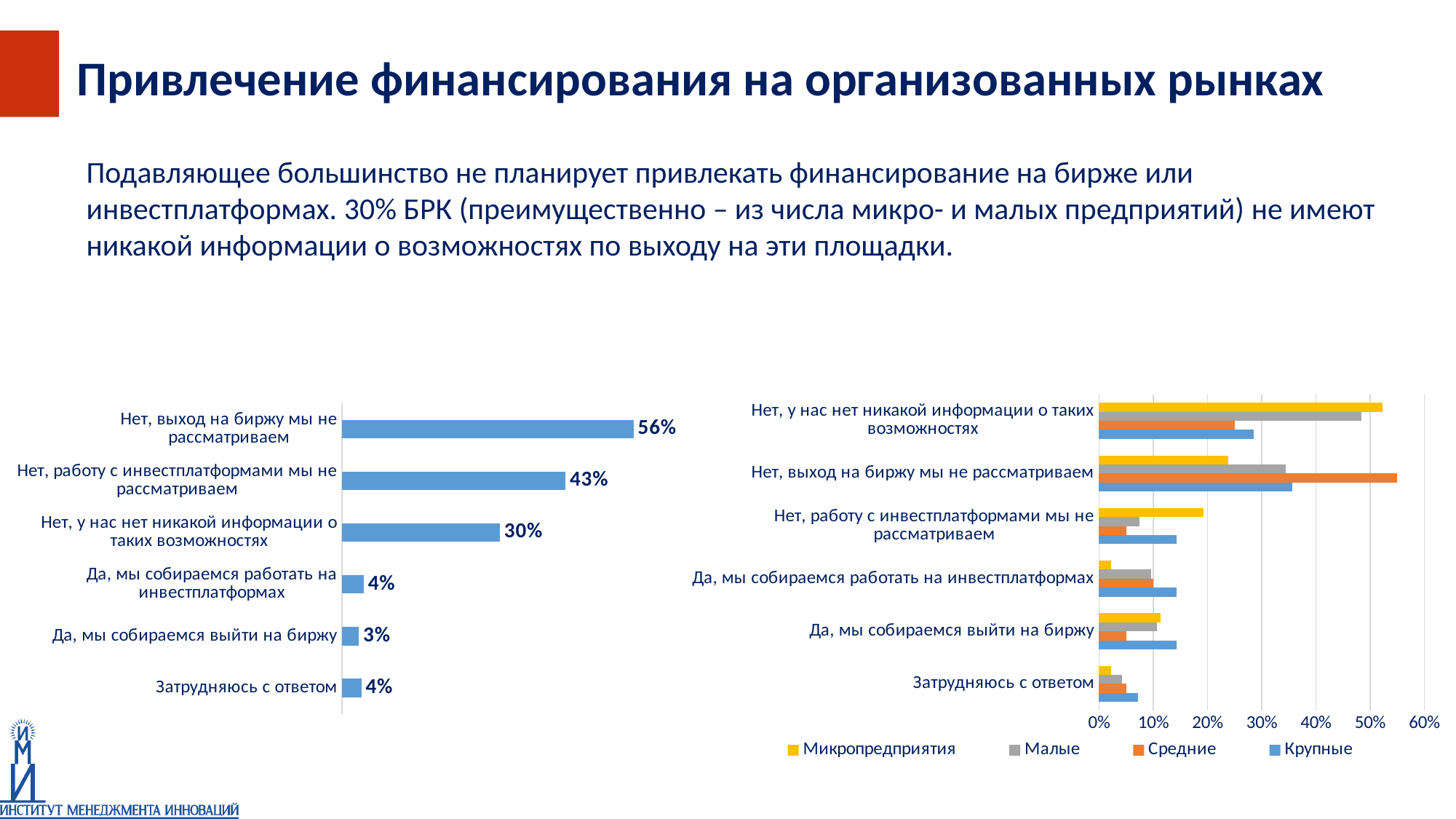
In the left chart, what is the value for "Нет, выход на биржу мы не рассматриваем"? 56% In the left chart, which category has the lowest value? Да, мы собираемся выйти на биржу In the right chart, how many series does the legend list? 4 In the left chart, what is the difference between "Нет, выход на биржу мы не рассматриваем" and "Нет, работу с инвестплатформами мы не рассматриваем"? 13% In the right chart, is the value of Средние for "Нет, выход на биржу мы не рассматриваем" greater or less than 50%? greater In the left chart, which category has the highest value? Нет, выход на биржу мы не рассматриваем In the left chart, how many categories are shown? 6 In the right chart, is the value of Малые for "Нет, выход на биржу мы не рассматриваем" greater or less than 30%? greater What kind of chart is the left chart? Bar chart In the left chart, what is the value for "Нет, у нас нет никакой информации о таких возможностях"? 30% In the right chart, which series is shown in orange? Средние In the right chart, for "Нет, выход на биржу мы не рассматриваем", which is larger: Средние or Микропредприятия? Средние